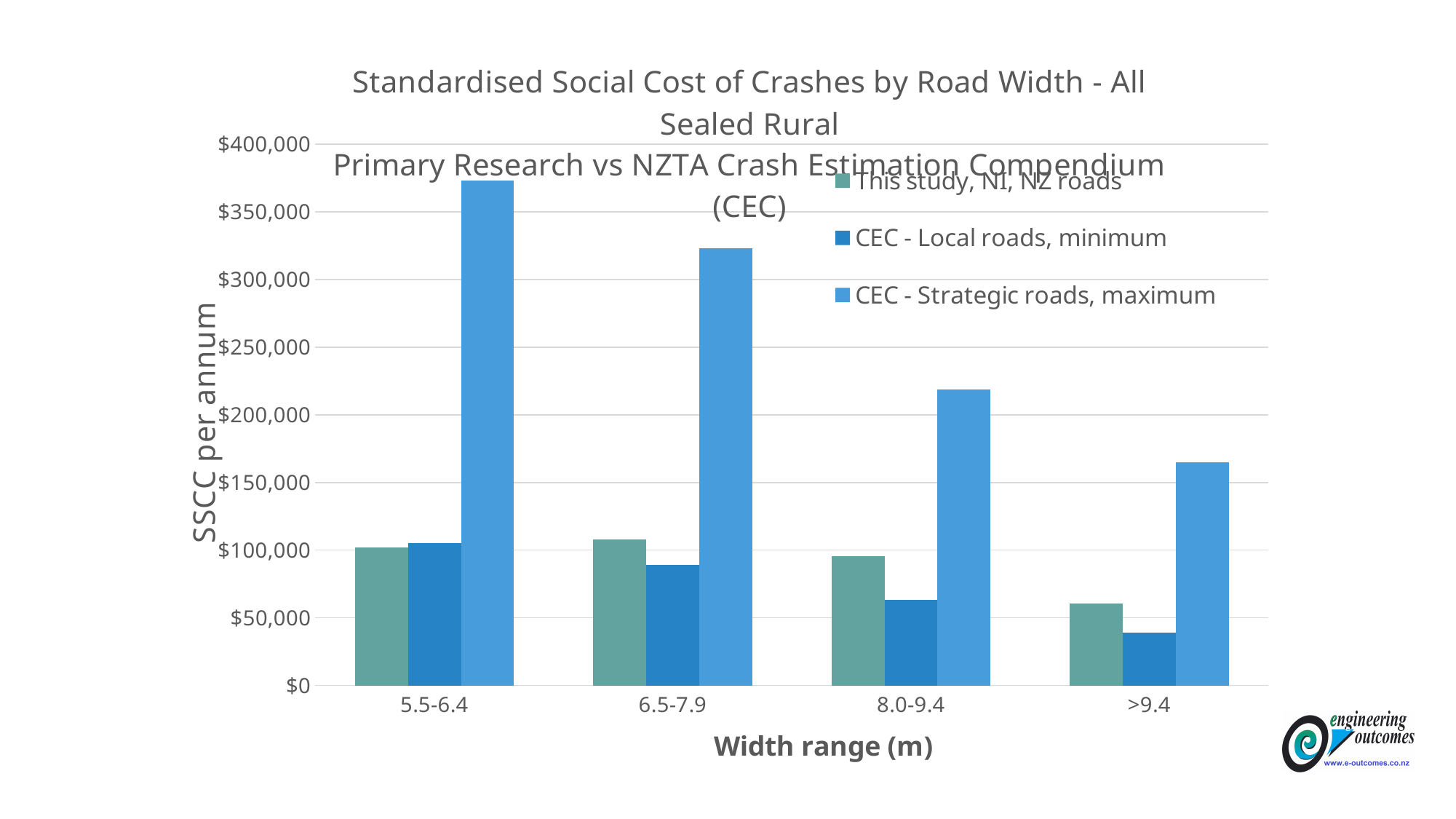
Is the CEC - Strategic roads, maximum value for 5.5-6.4 greater or less than $350,000? greater What is the label of the y axis? SSCC per annum Do the values for the CEC - Strategic roads, maximum series rise or fall as the width range increases along the x axis? fall What kind of chart is shown on the slide? Bar chart For the 6.5-7.9 width range, which is larger: This study, NI, NZ roads or CEC - Local roads, minimum? This study, NI, NZ roads Is the CEC - Strategic roads, maximum value for 8.0-9.4 greater or less than $200,000? greater How many width range categories are shown on the x axis? 4 Which width range has the lowest value for the This study, NI, NZ roads series? >9.4 Which width range has the highest value for the CEC - Strategic roads, maximum series? 5.5-6.4 Which width range has the lowest value for the CEC - Strategic roads, maximum series? >9.4 Is the CEC - Local roads, minimum value for >9.4 greater or less than $50,000? less How many series does the legend list? 3